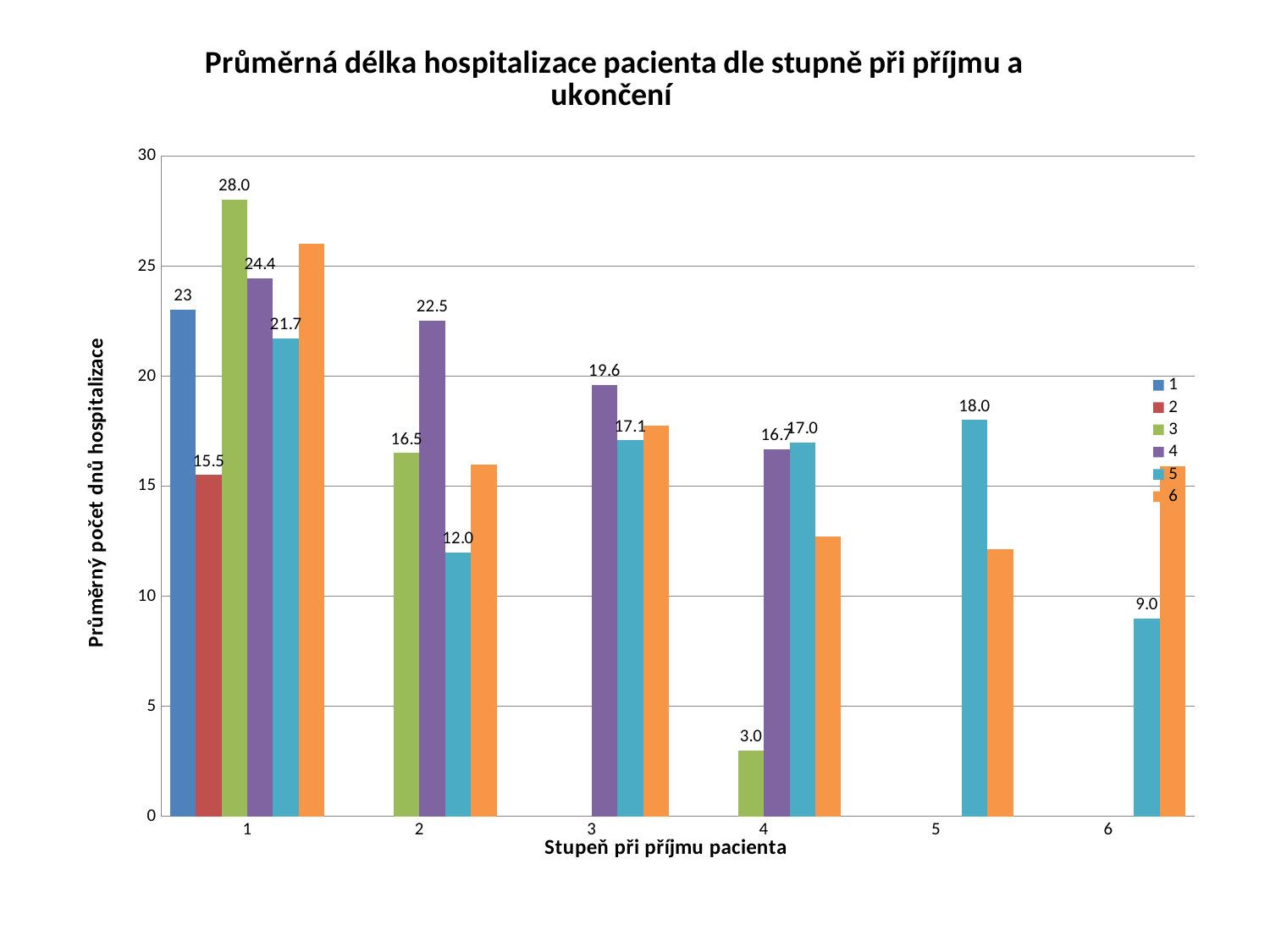
What kind of chart is shown on the slide? bar chart Is the value for series 6 at category 5 greater or less than 15? less Which series has the lowest value at category 4? 3 What is the value for series 3 at category 4? 3.0 Which series has the highest value at category 1? 3 What is the value for series 3 at category 1 on the x axis? 28.0 What is the difference between series 4 and series 5 at category 2? 10.5 How many series does the legend list? 6 Is the value for series 6 at category 1 greater or less than 25? greater For series 5, which is larger: the value at category 5 or the value at category 6? category 5 What is the value for series 5 at category 2? 12.0 What is the value for series 4 at category 3? 19.6